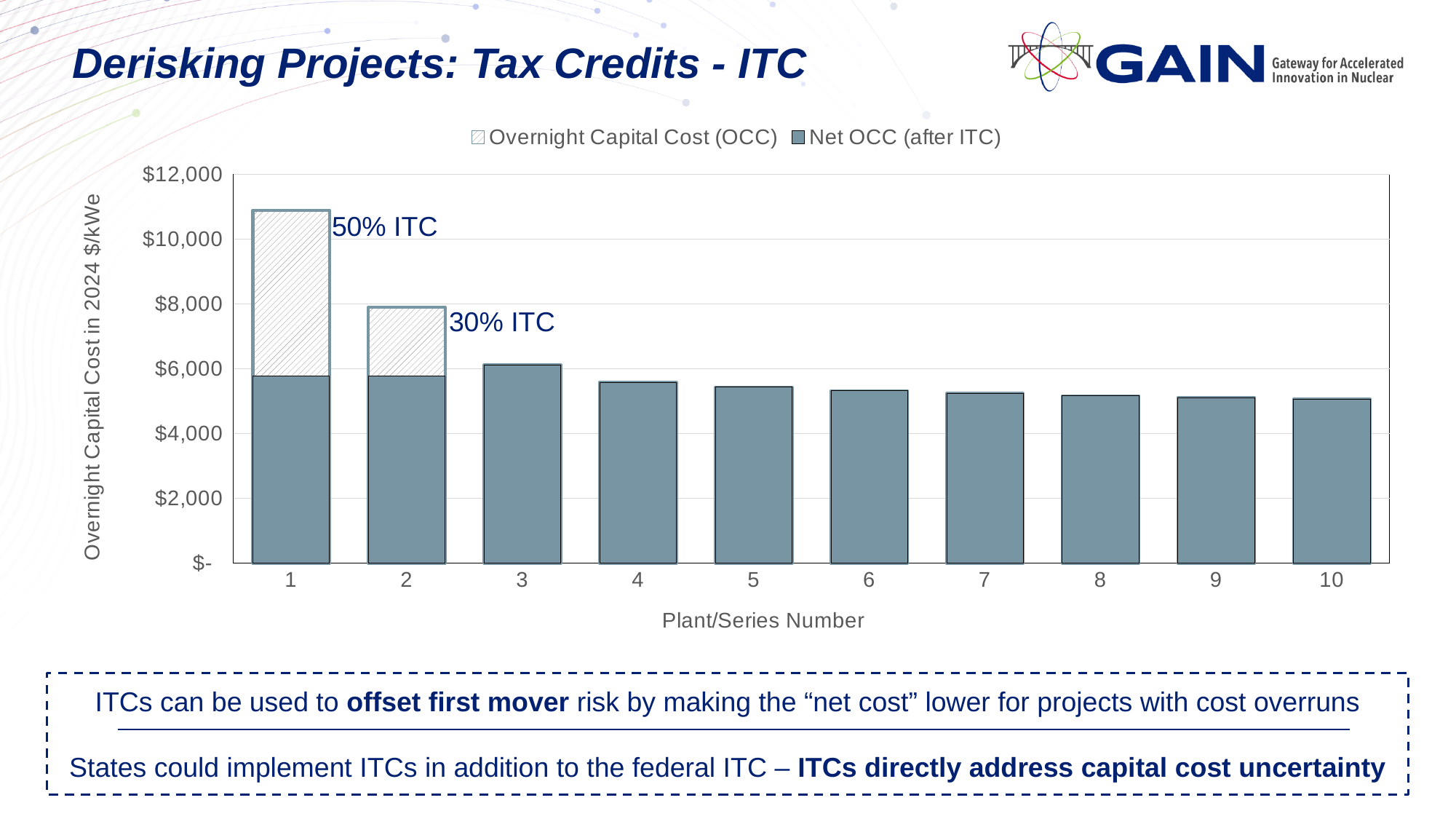
Is the Net OCC (after ITC) for plant/series number 10 greater or less than $4,000? greater What kind of chart is shown on the slide? bar chart Is the Overnight Capital Cost (OCC) for plant/series number 1 greater or less than $10,000? greater Is the Net OCC (after ITC) for plant/series number 10 greater or less than $6,000? less How many series does the chart legend list? 2 Do the Net OCC (after ITC) values rise or fall from plant/series number 3 to plant/series number 10? fall Which is larger: the Overnight Capital Cost (OCC) for plant/series number 1 or the Net OCC (after ITC) for plant/series number 3? plant/series number 1 What ITC percentage is annotated next to the bar for plant/series number 2? 30% ITC What is the title of the y axis of the chart? Overnight Capital Cost in 2024 $/kWe Which plant/series number has the highest Overnight Capital Cost (OCC)? 1 How many plant/series numbers are shown on the x axis of the chart? 10